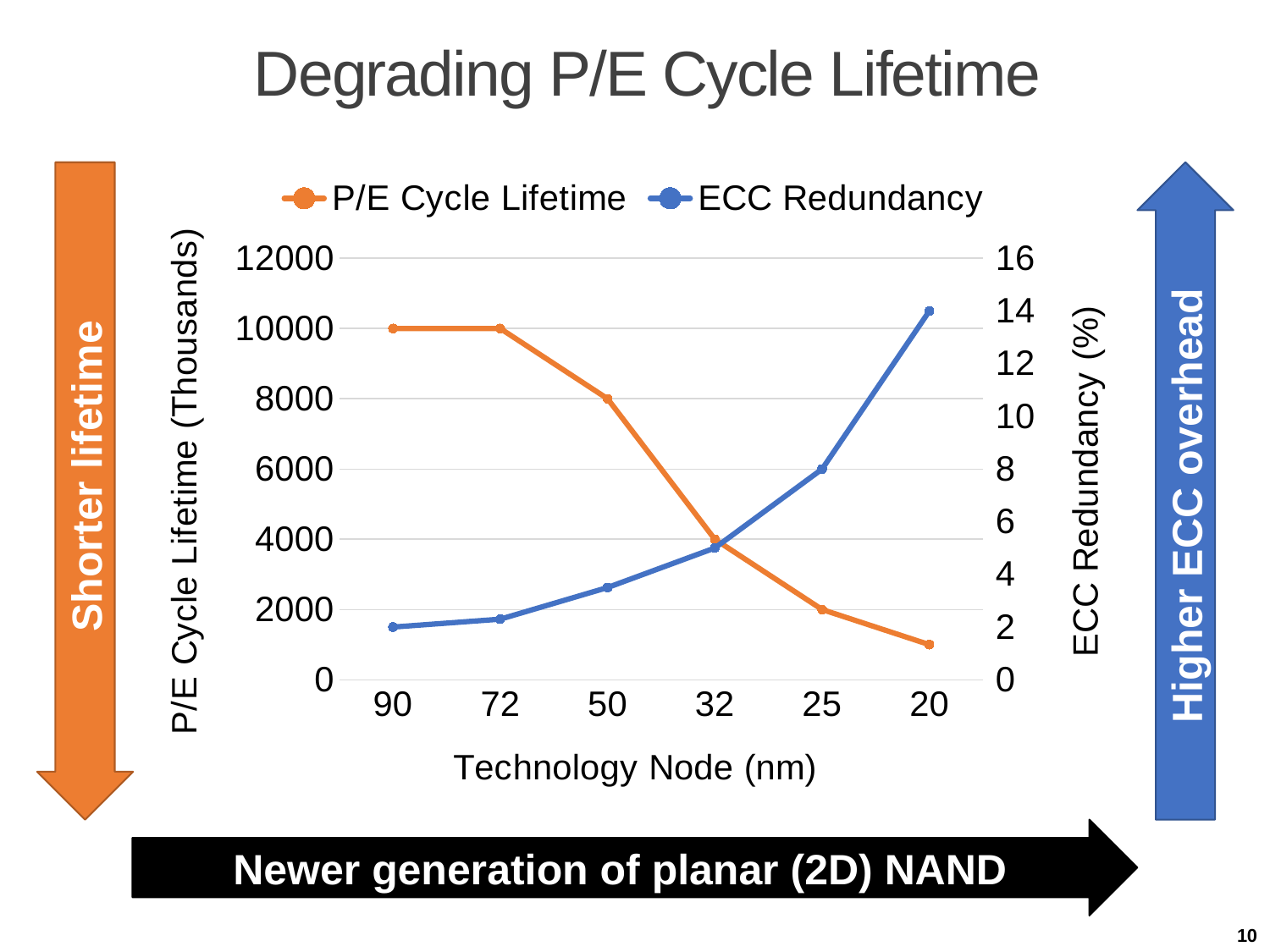
What kind of chart is shown on the slide? line chart Does the P/E Cycle Lifetime rise or fall moving from 90 nm to 20 nm along the x axis? fall How many technology nodes are plotted along the x axis? 6 What is the title of the x axis? Technology Node (nm) Is the ECC Redundancy at the 32 nm node greater or less than 6? less At which technology node is the ECC Redundancy highest? 20 What is the difference in P/E Cycle Lifetime (Thousands) between the 50 nm and 32 nm nodes? 4000 How many series does the legend list? 2 Is the P/E Cycle Lifetime at the 20 nm node greater or less than 2000? less At which technology node is the P/E Cycle Lifetime lowest? 20 What is the ECC Redundancy (%) at the 20 nm technology node? 14 What is the P/E Cycle Lifetime (Thousands) at the 50 nm technology node? 8000